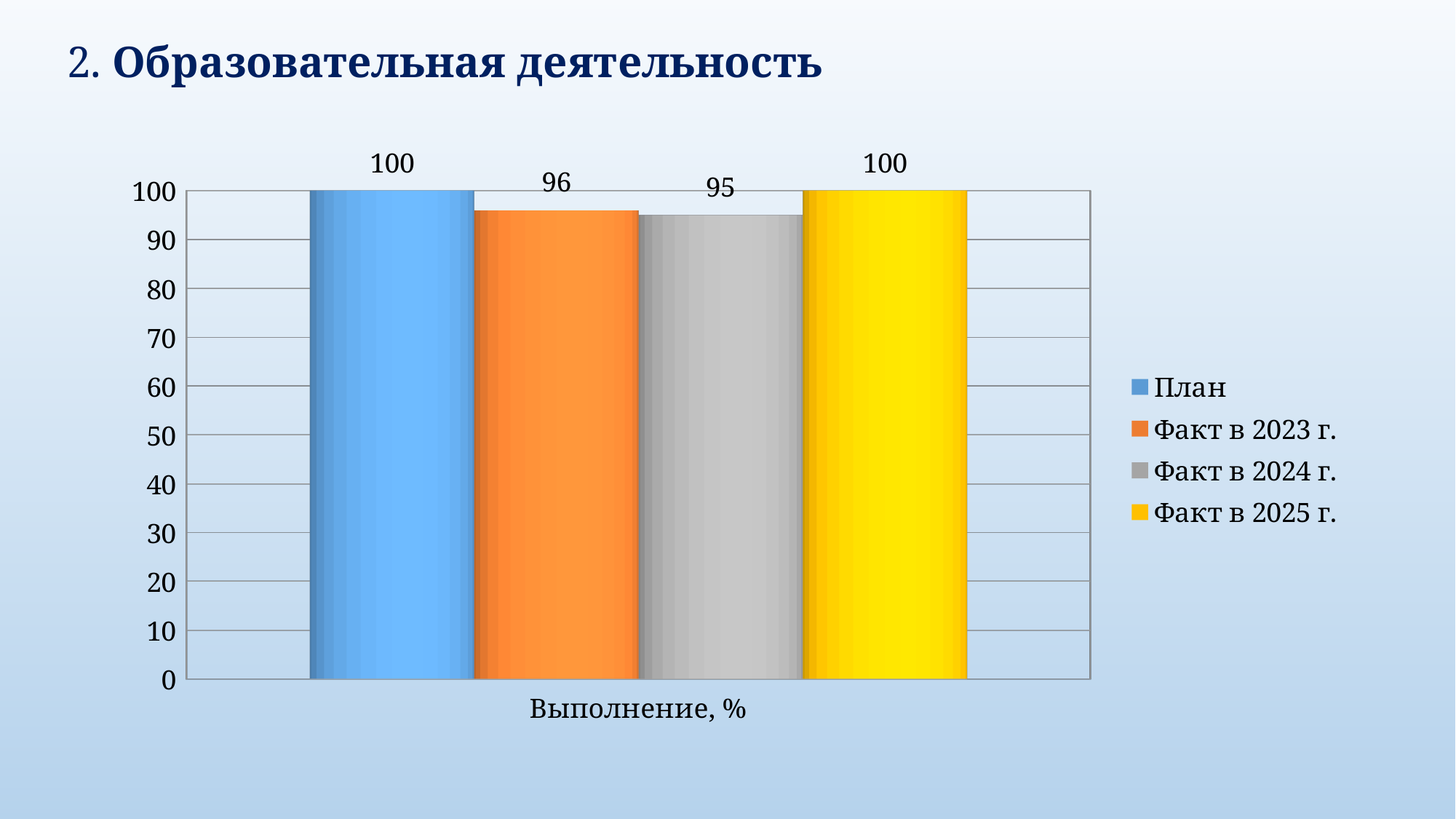
What is the difference between the values for План and Факт в 2023 г.? 4 What is the value for Факт в 2025 г.? 100 How many series does the legend list? 4 What is the label on the x axis of the chart? Выполнение, % What is the difference between the values for Факт в 2023 г. and Факт в 2024 г.? 1 Is the value for Факт в 2024 г. greater or less than 90? greater What is the value for Факт в 2023 г.? 96 What kind of chart is shown on the slide? bar chart Which series has the lowest value? Факт в 2024 г. What is the value for План? 100 Which is larger, the value for Факт в 2023 г. or Факт в 2024 г.? Факт в 2023 г. What is the value for Факт в 2024 г.? 95